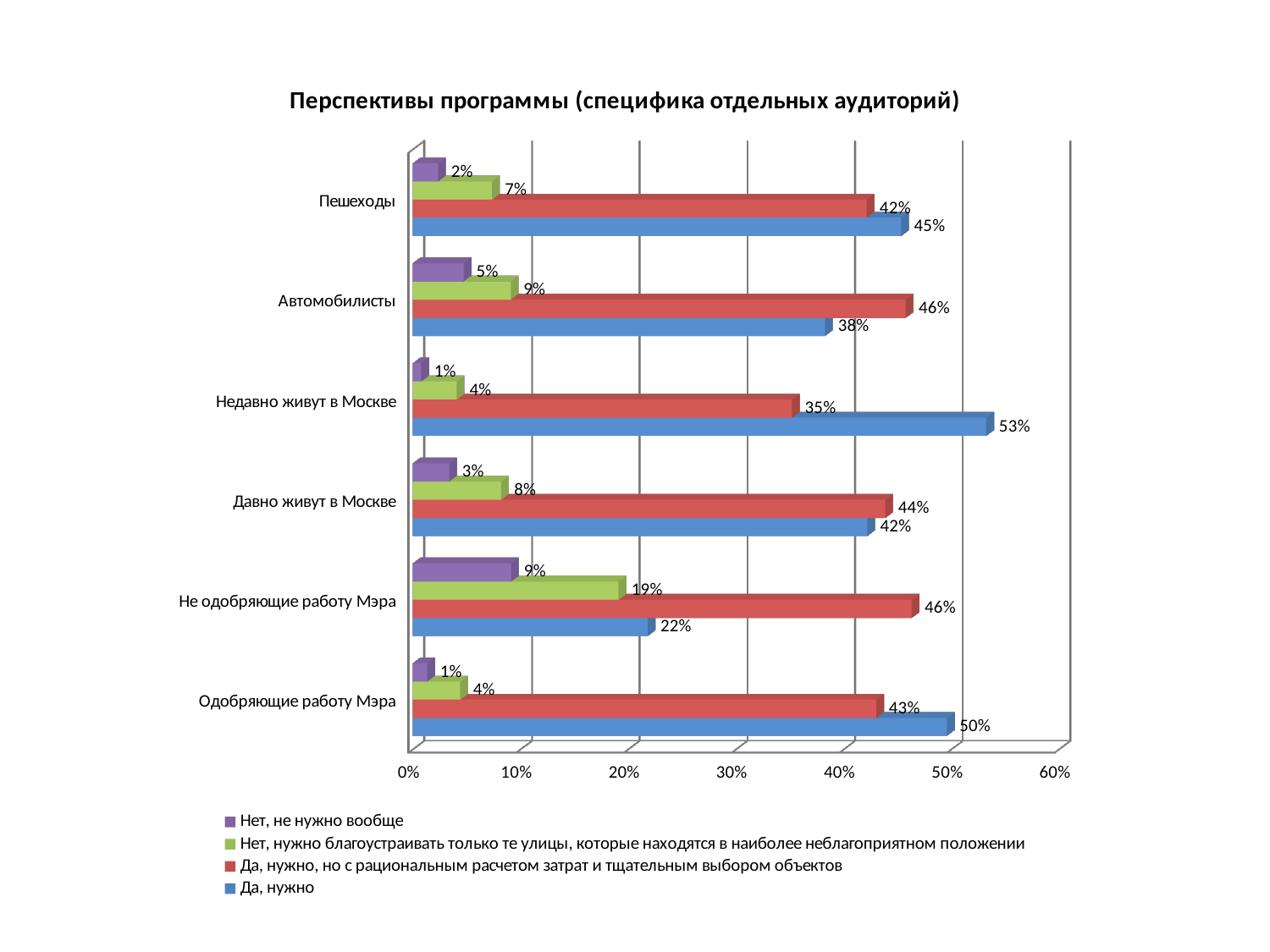
What is the difference between the "Да, нужно" values for Одобряющие работу Мэра and Не одобряющие работу Мэра? 28% Is the value of "Да, нужно" for Автомобилисты greater or less than 40%? less What is the value of "Нет, не нужно вообще" for Не одобряющие работу Мэра? 9% For Пешеходы, which is larger: "Да, нужно" or "Да, нужно, но с рациональным расчетом затрат и тщательным выбором объектов"? Да, нужно How many series does the legend list? 4 What kind of chart is shown on the slide? Bar chart What is the value of "Да, нужно" for Недавно живут в Москве? 53% What is the title of the chart? Перспективы программы (специфика отдельных аудиторий) How many categories are shown on the chart? 6 Which category has the highest value for "Да, нужно"? Недавно живут в Москве What is the value of "Да, нужно, но с рациональным расчетом затрат и тщательным выбором объектов" for Автомобилисты? 46% Which category has the lowest value for "Да, нужно"? Не одобряющие работу Мэра